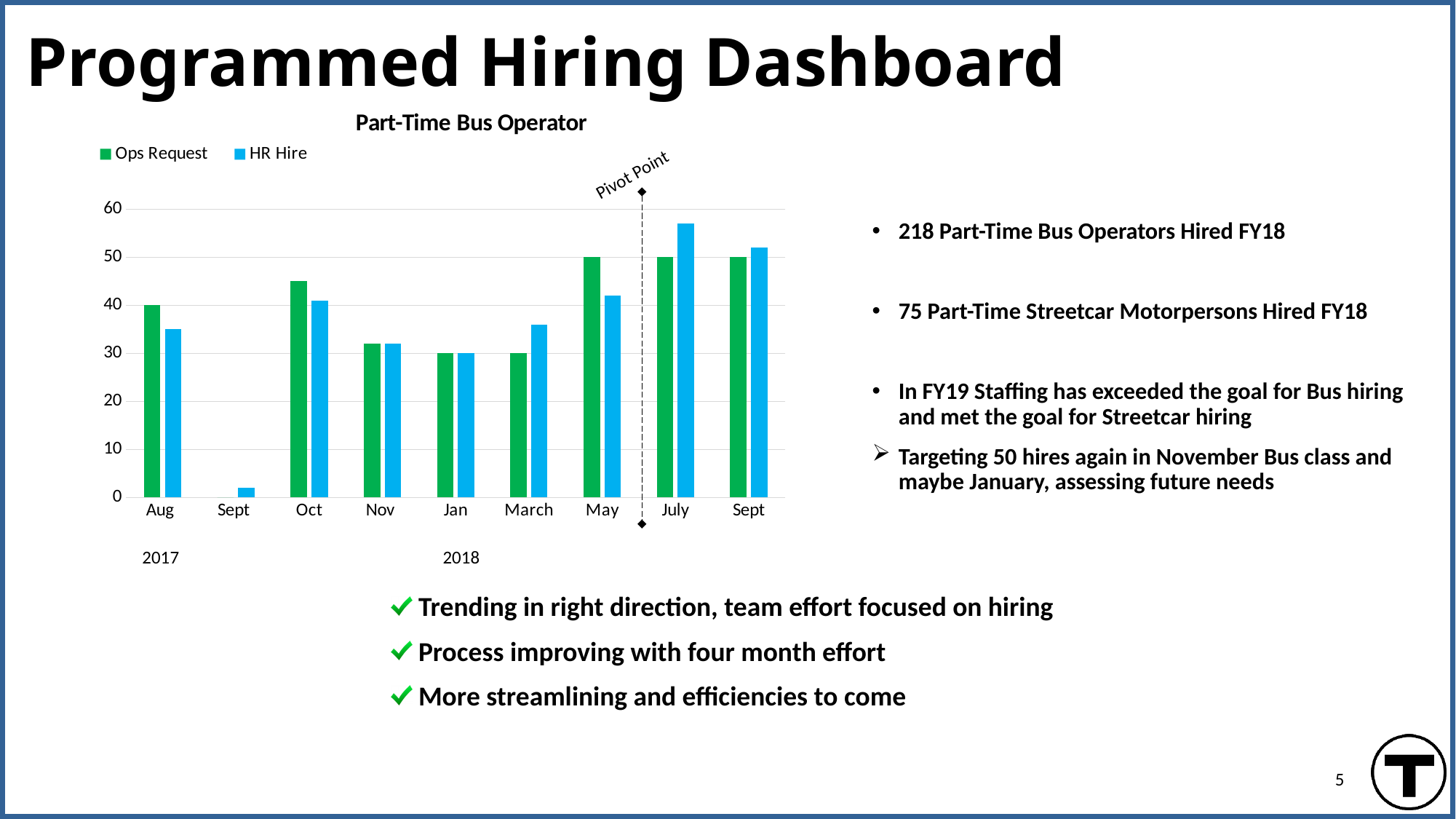
In which month is the HR Hire value lowest? Sept 2017 What type of chart is shown on the slide? bar chart How many series does the chart legend list? 2 Is the Ops Request value for Oct 2017 greater or less than 40? greater For July 2018, which is larger: Ops Request or HR Hire? HR Hire What is the HR Hire value for Jan 2018? 30 What is the Ops Request value for July 2018? 50 What is the Ops Request value for Aug 2017? 40 Is the HR Hire value for Aug 2017 greater or less than 40? less In which month is the HR Hire value highest? July How many months are shown on the x axis of the chart? 9 What is the title of the chart? Part-Time Bus Operator